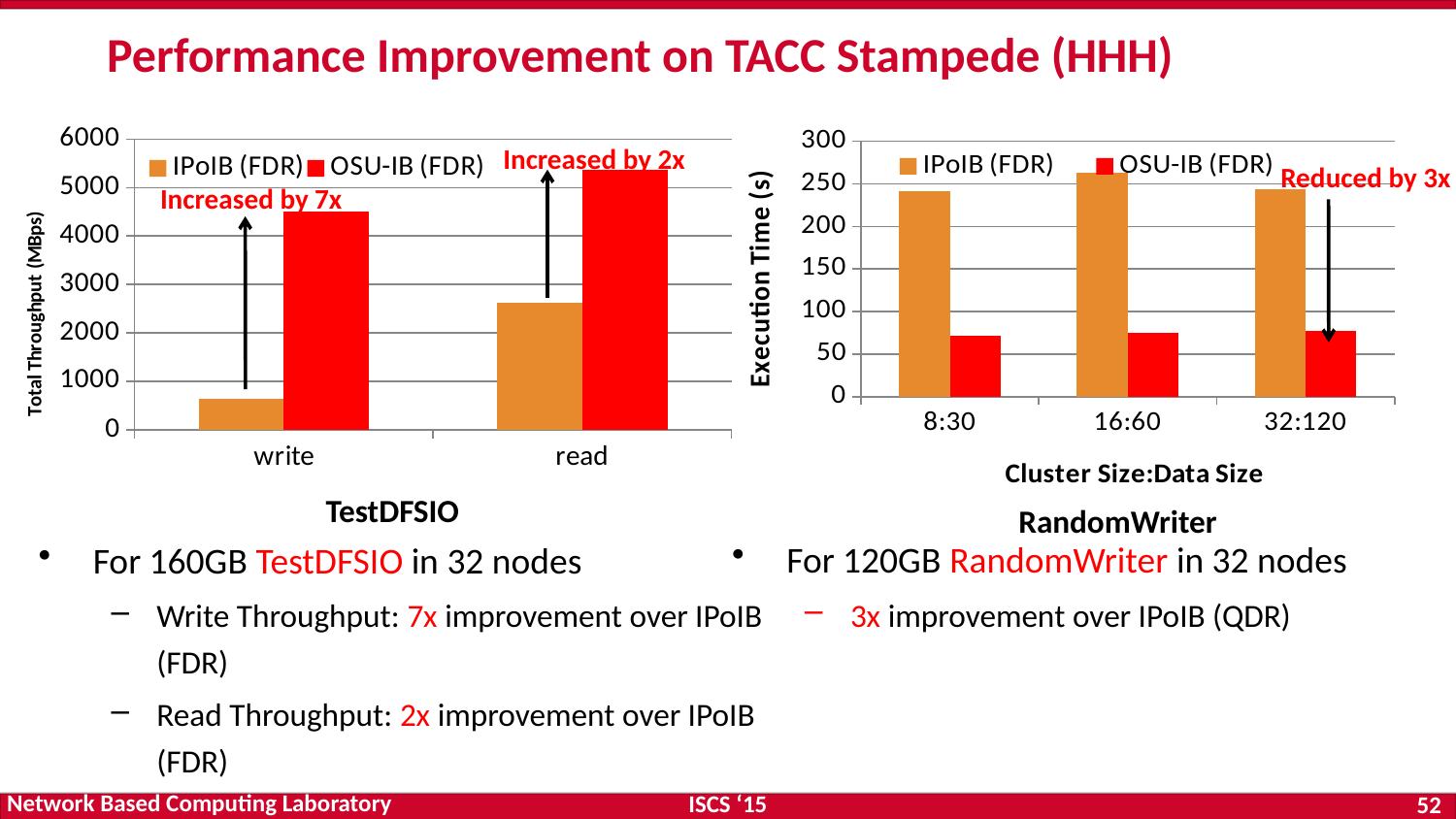
In the RandomWriter chart, which series has the larger execution time at 32:120, IPoIB (FDR) or OSU-IB (FDR)? IPoIB (FDR) In the RandomWriter chart, how many cluster size:data size categories are shown? 3 In the TestDFSIO chart, how many series does the legend list? 2 What kind of chart is the TestDFSIO chart on the left? bar chart In the TestDFSIO chart, is the write throughput for IPoIB (FDR) greater or less than 1000? less In the TestDFSIO chart, is the read throughput for OSU-IB (FDR) greater or less than 5000? greater In the TestDFSIO chart, how many categories are shown on the x axis? 2 In the TestDFSIO chart, does the IPoIB (FDR) throughput rise or fall from write to read? rise In the RandomWriter chart, what is the x-axis title? Cluster Size:Data Size In the TestDFSIO chart, which series has the larger write throughput, IPoIB (FDR) or OSU-IB (FDR)? OSU-IB (FDR) In the RandomWriter chart, is the execution time for IPoIB (FDR) at 16:60 greater or less than 200? greater